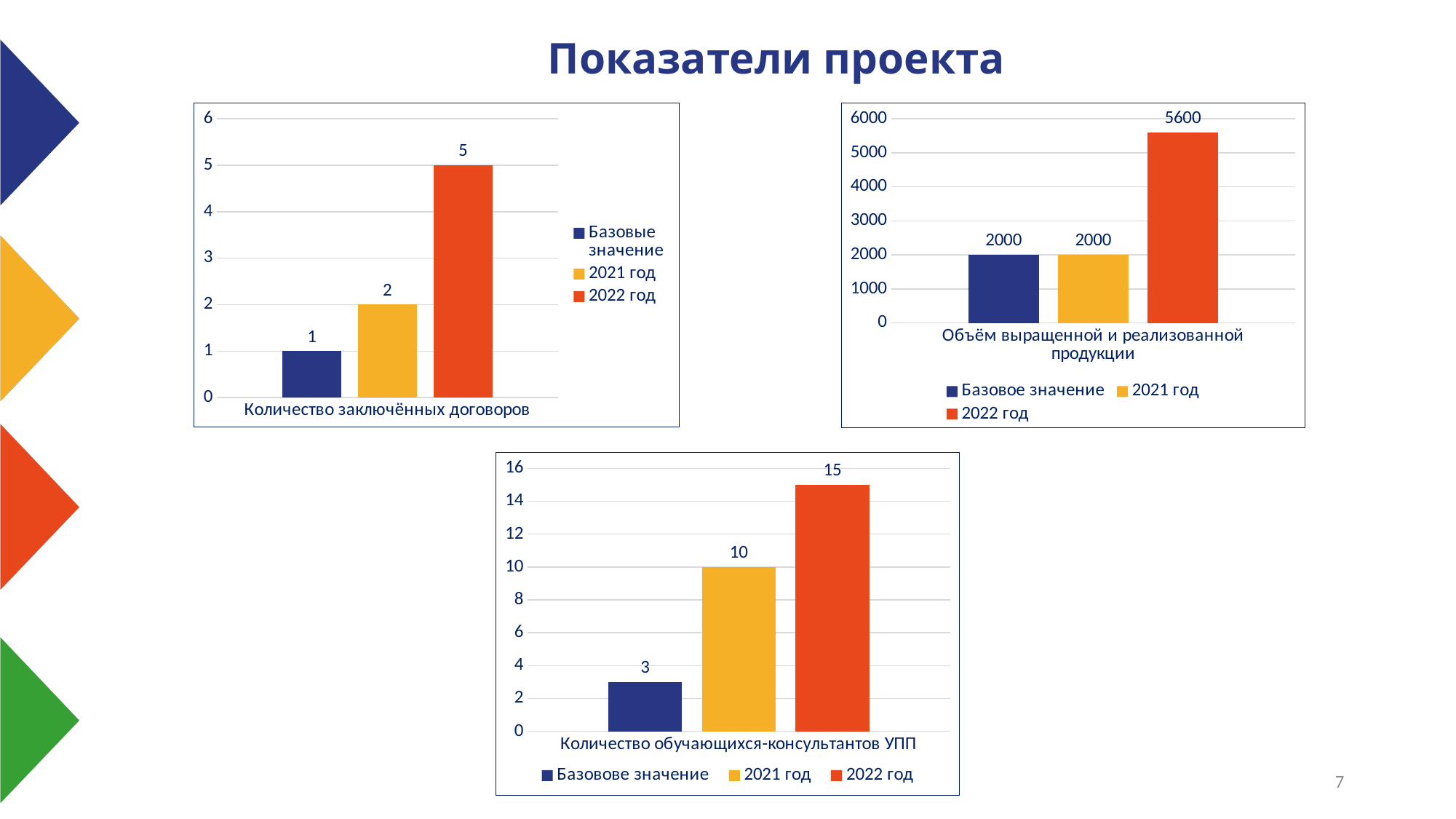
In the top-right chart (Объём выращенной и реализованной продукции), how many series does the legend list? 3 In the top-left chart (Количество заключённых договоров), what is the value for 2022 год? 5 In the bottom chart (Количество обучающихся-консультантов УПП), what is the difference between the 2022 год value and the Базовове значение value? 12 In the top-right chart (Объём выращенной и реализованной продукции), what is the value for 2022 год? 5600 What kind of chart is the bottom chart (Количество обучающихся-консультантов УПП)? Bar chart In the top-right chart (Объём выращенной и реализованной продукции), what is the difference between the 2022 год value and the Базовое значение value? 3600 In the top-left chart (Количество заключённых договоров), what is the value for Базовые значение? 1 In the bottom chart (Количество обучающихся-консультантов УПП), which series has the lowest value? Базовове значение In the bottom chart (Количество обучающихся-консультантов УПП), what is the value for 2021 год? 10 In the top-left chart (Количество заключённых договоров), what is the difference between the 2022 год value and the 2021 год value? 3 In the bottom chart (Количество обучающихся-консультантов УПП), which is larger: the value for 2021 год or the value for 2022 год? 2022 год In the top-right chart (Объём выращенной и реализованной продукции), which series has the highest value? 2022 год